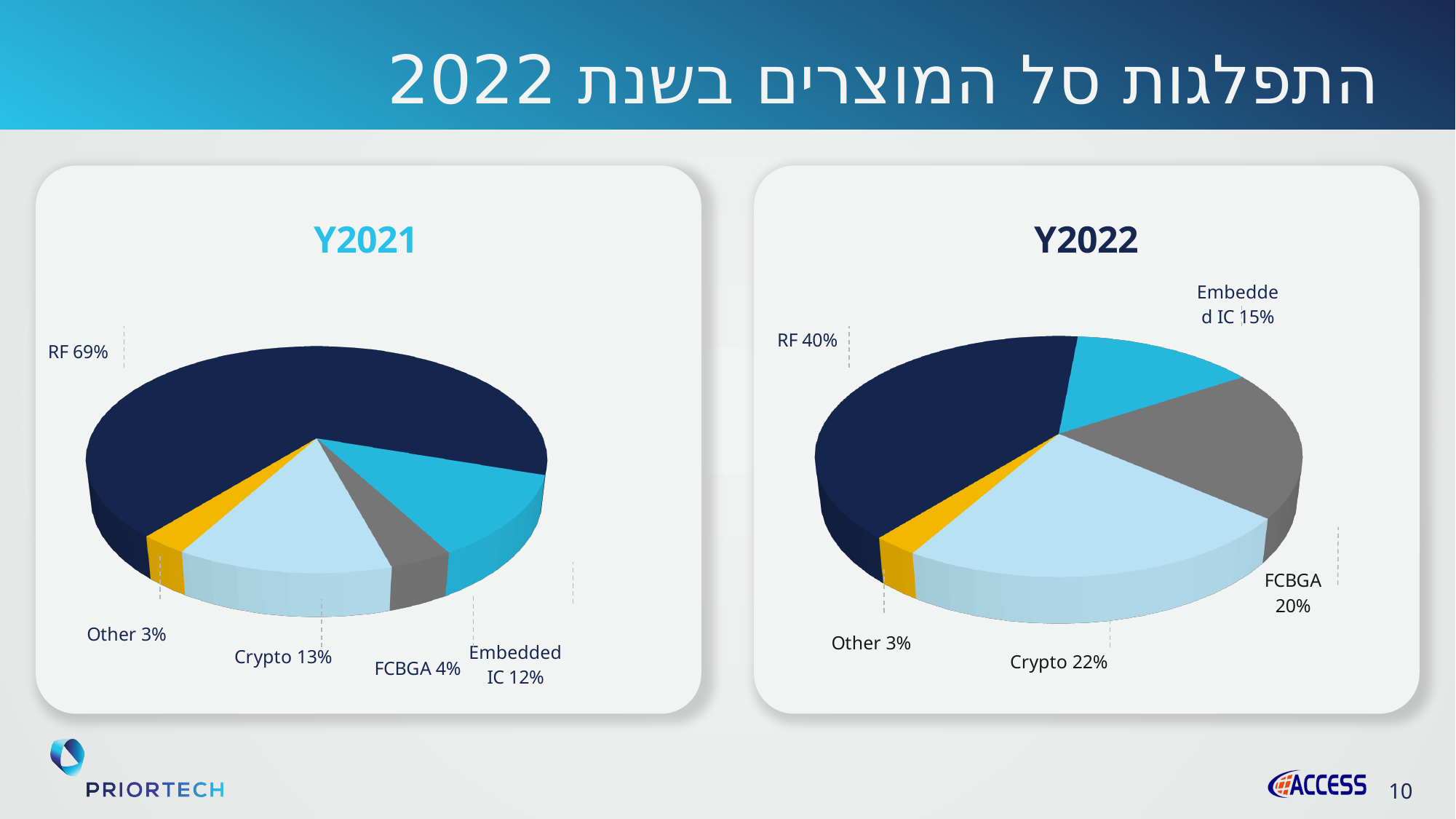
In the Y2022 pie chart, which is larger: the Crypto share or the FCBGA share? Crypto In the Y2021 pie chart, which category has the largest share? RF In the Y2021 pie chart, what share does Embedded IC have? 12% In the Y2022 pie chart, which category has the smallest share? Other In the Y2021 pie chart, what share does RF have? 69% What is the difference between the RF share in the Y2021 chart and the RF share in the Y2022 chart? 29 percentage points What is the difference between the FCBGA share in the Y2022 chart and the FCBGA share in the Y2021 chart? 16 percentage points What type of chart is used on the slide for Y2021 and Y2022? Pie chart In the Y2022 pie chart, what share does FCBGA have? 20% How many categories are shown in the Y2022 pie chart? 5 In the Y2021 pie chart, which category has the smallest share? Other In the Y2022 pie chart, what share does Crypto have? 22%